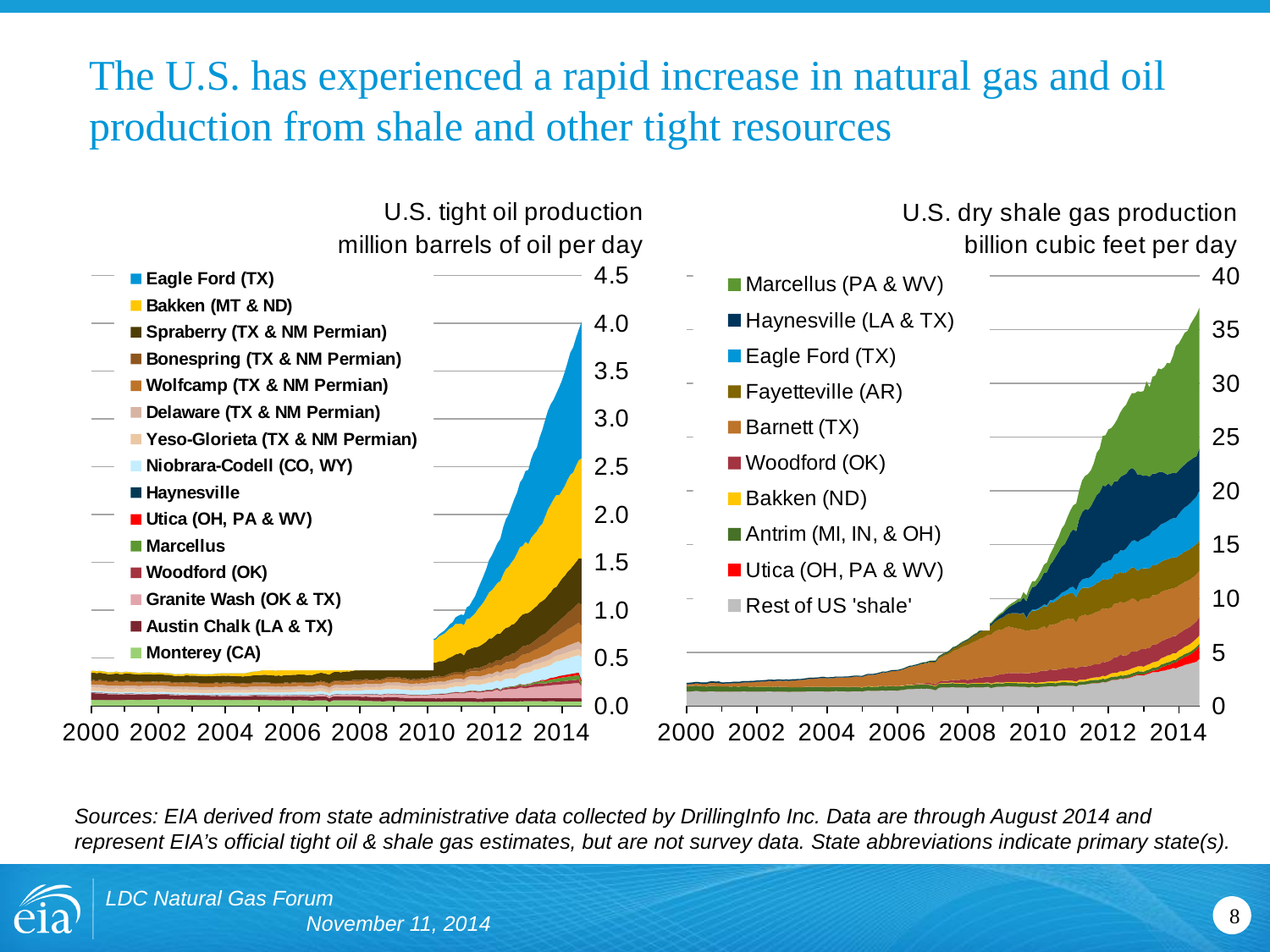
What kind of chart is the U.S. tight oil production chart on the left? Stacked area chart What unit is used on the U.S. tight oil production chart? million barrels of oil per day In the U.S. dry shale gas production chart, is total production in 2000 greater or less than 5 billion cubic feet per day? less What kind of chart is the U.S. dry shale gas production chart on the right? Stacked area chart How many series does the legend of the U.S. dry shale gas production chart list? 10 In the U.S. dry shale gas production chart, is total production at the end of 2014 greater or less than 30 billion cubic feet per day? greater In the U.S. tight oil production chart, is total production at the end of 2014 greater or less than 3.0 million barrels per day? greater Which series is listed first in the legend of the U.S. dry shale gas production chart? Marcellus (PA & WV) In the U.S. dry shale gas production chart, does total production rise or fall from 2000 to 2014? Rise In the U.S. tight oil production chart, does total production rise or fall between 2010 and 2014? Rise In the U.S. dry shale gas production chart, which play contributes the largest share of production in 2014? Marcellus (PA & WV) How many series does the legend of the U.S. tight oil production chart list? 15